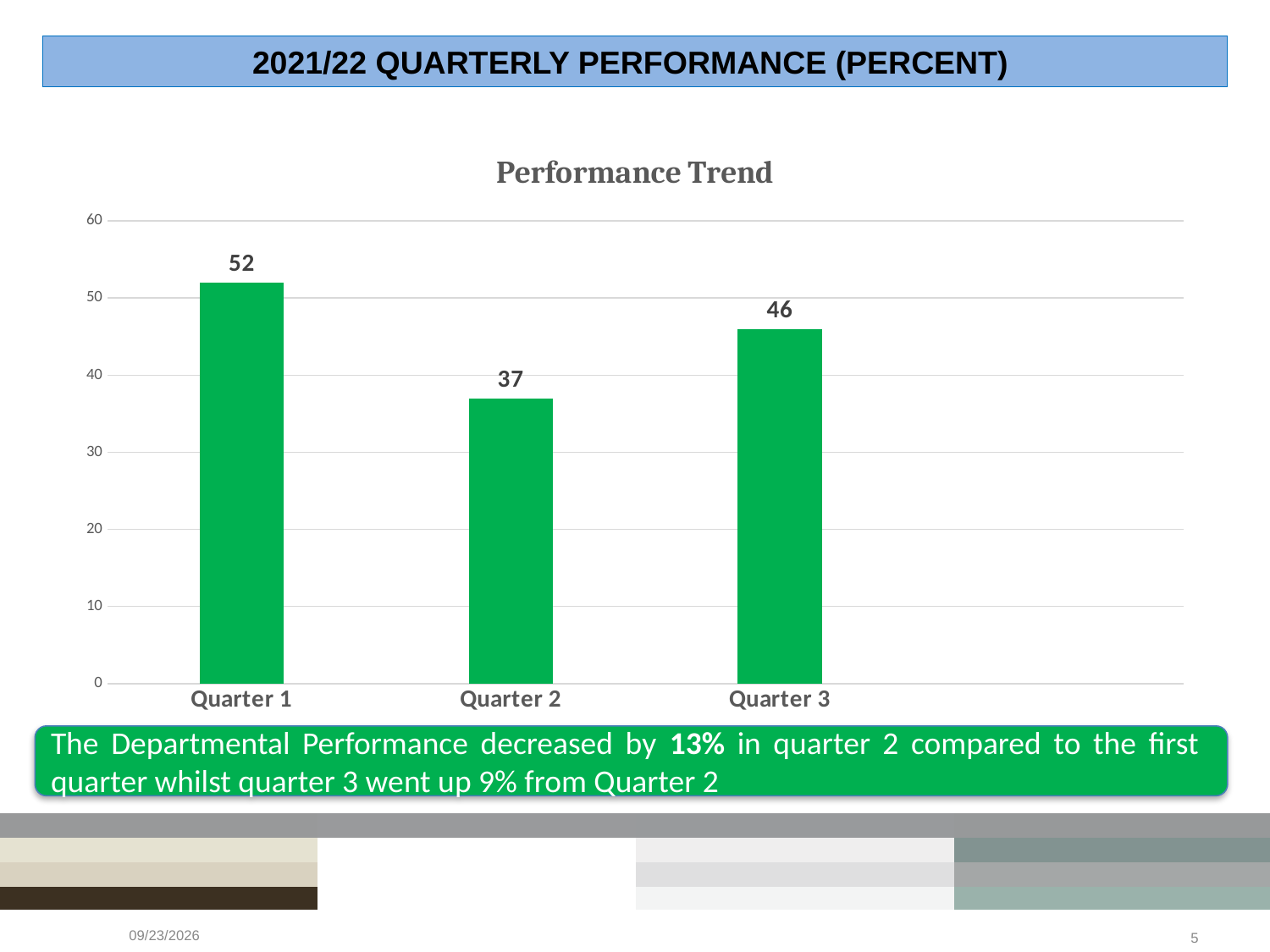
Is the value for Quarter 2 greater or less than 40? less What is the title of the chart? Performance Trend How many quarters are shown in the chart? 3 What is the difference between the values for Quarter 3 and Quarter 2? 9 What is the value for Quarter 3? 46 Which quarter has the lowest value? Quarter 2 Which is larger, the value for Quarter 1 or the value for Quarter 3? Quarter 1 What kind of chart is shown on the slide? bar chart What is the difference between the values for Quarter 1 and Quarter 2? 15 What is the value for Quarter 1? 52 Which quarter has the highest value? Quarter 1 What is the value for Quarter 2? 37